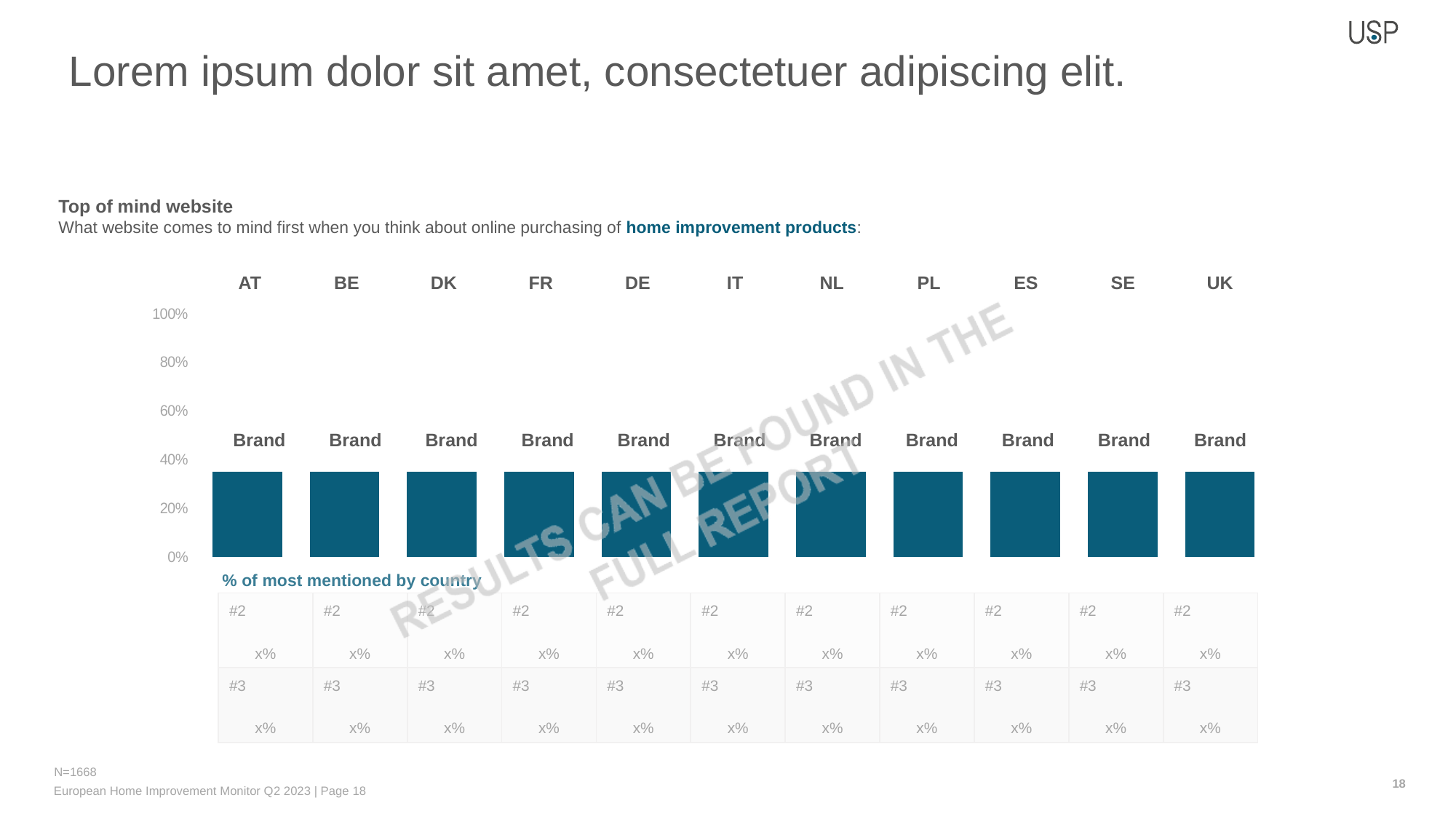
Which country label appears first (leftmost) on the x axis? AT What is the heading of the chart section on the slide? Top of mind website How many countries are shown along the x axis of the chart? 11 What kind of chart is shown on the slide? bar chart Is the value for DE greater or less than 60%? less Which country label appears last (rightmost) on the x axis? UK Is the value for UK greater or less than 20%? greater Is the value for AT greater or less than 40%? less What is the highest value shown on the y axis of the chart? 100%